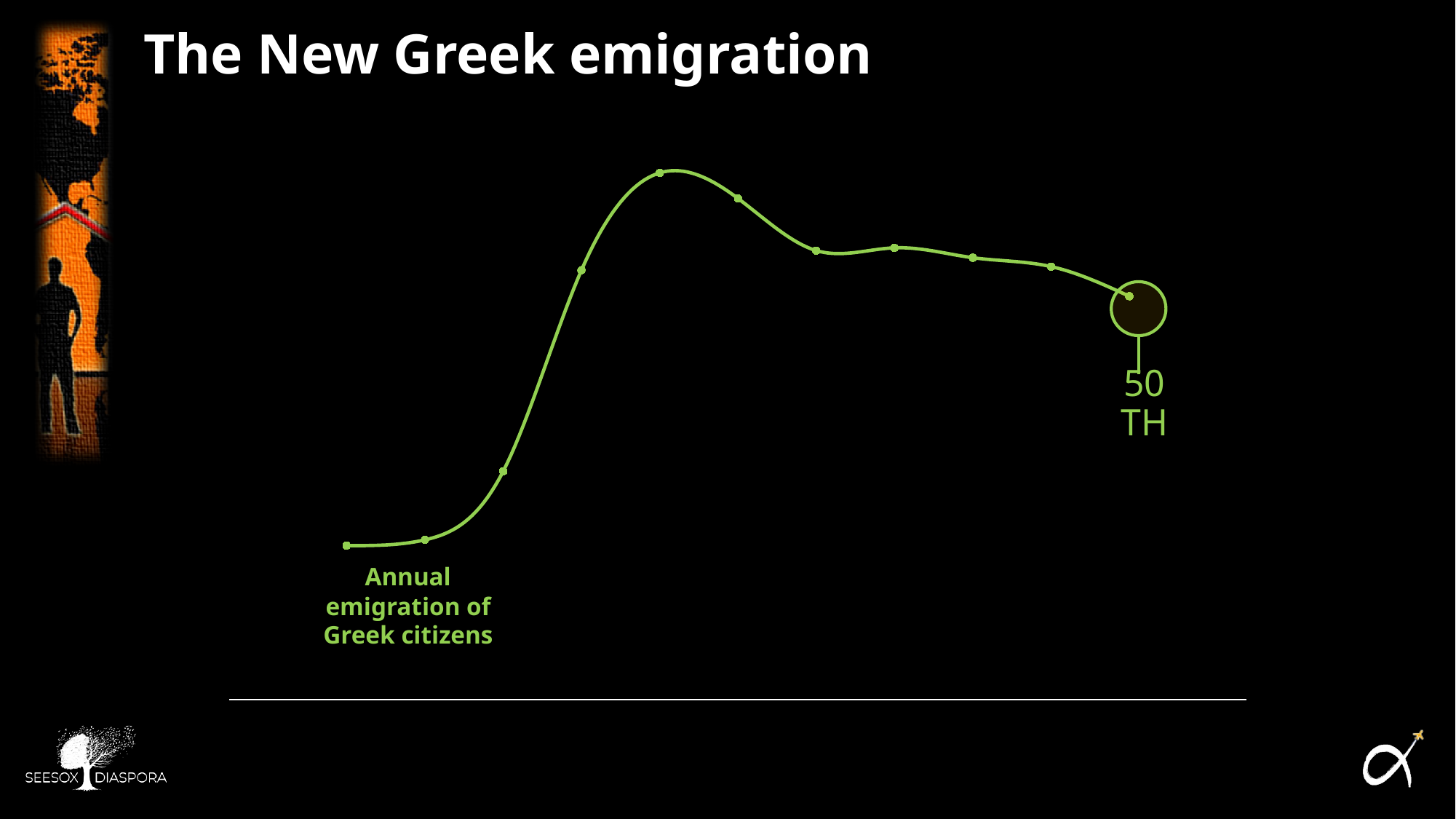
What value is labelled on the rightmost (final) point of the line? 50 TH What kind of chart is shown on the slide? line chart How many data points are plotted on the line? 11 What is the title of the slide? The New Greek emigration Is the final point of the line higher or lower than the peak of the line? lower What is the name of the series plotted on the chart? Annual emigration of Greek citizens Does the line rise or fall between the first point and the fifth point? rise Does the line rise or fall from its peak to the final point? fall Is the final point of the line higher or lower than the first point? higher How many series are plotted on the chart? 1